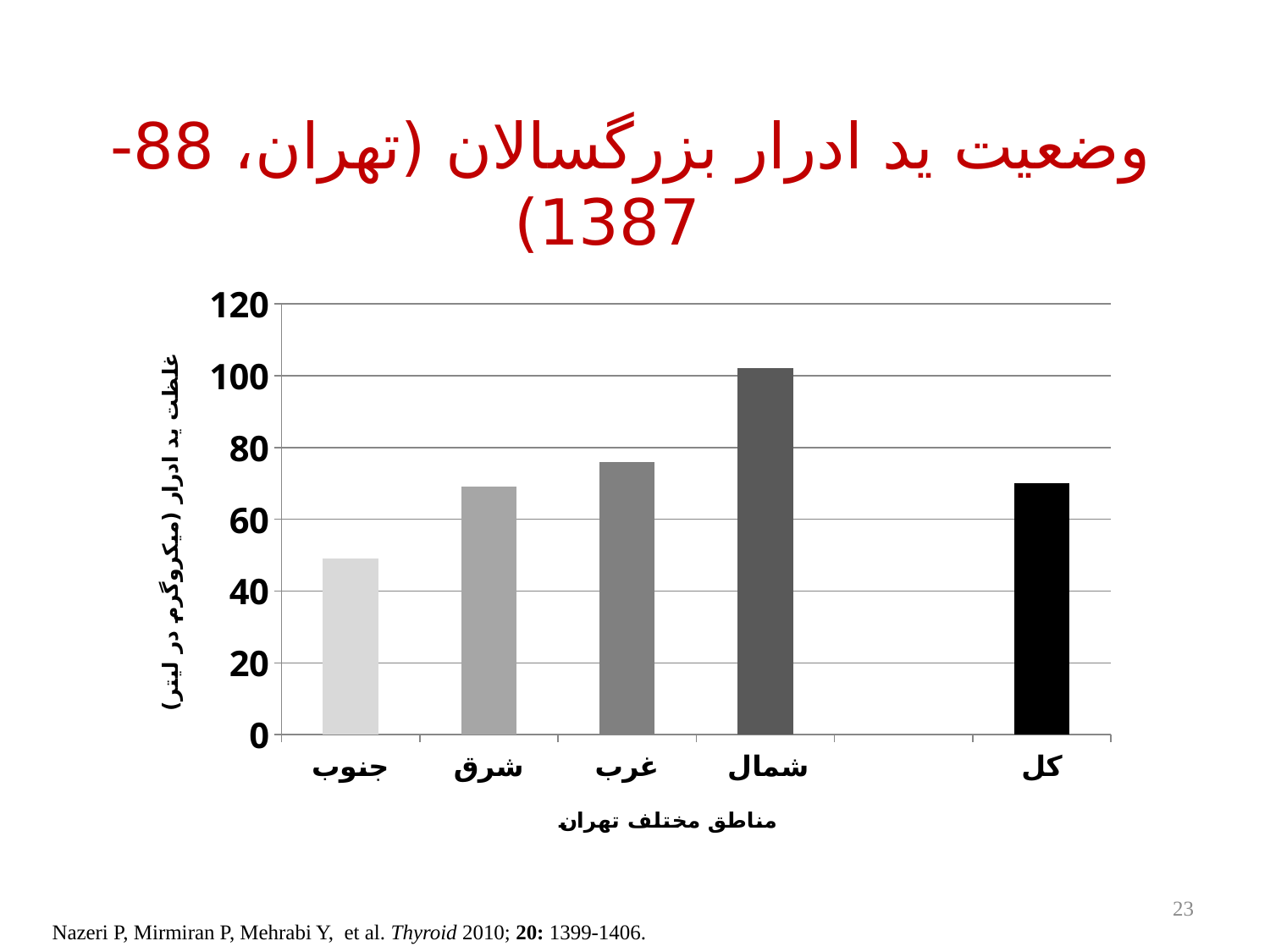
Is the value for شمال greater or less than 80? greater Which is larger, the value for جنوب or the value for شرق? شرق Is the value for جنوب greater or less than 60? less Which is larger, the value for شمال or the value for غرب? شمال Is the value for جنوب greater or less than 40? greater What kind of chart is shown on the slide? bar chart Which category has the lowest urinary iodine concentration? جنوب Which category has the highest urinary iodine concentration? شمال What is the title of the vertical axis of the chart? غلظت ید ادرار (میکروگرم در لیتر) How many categories (bars) are plotted in the chart? 5